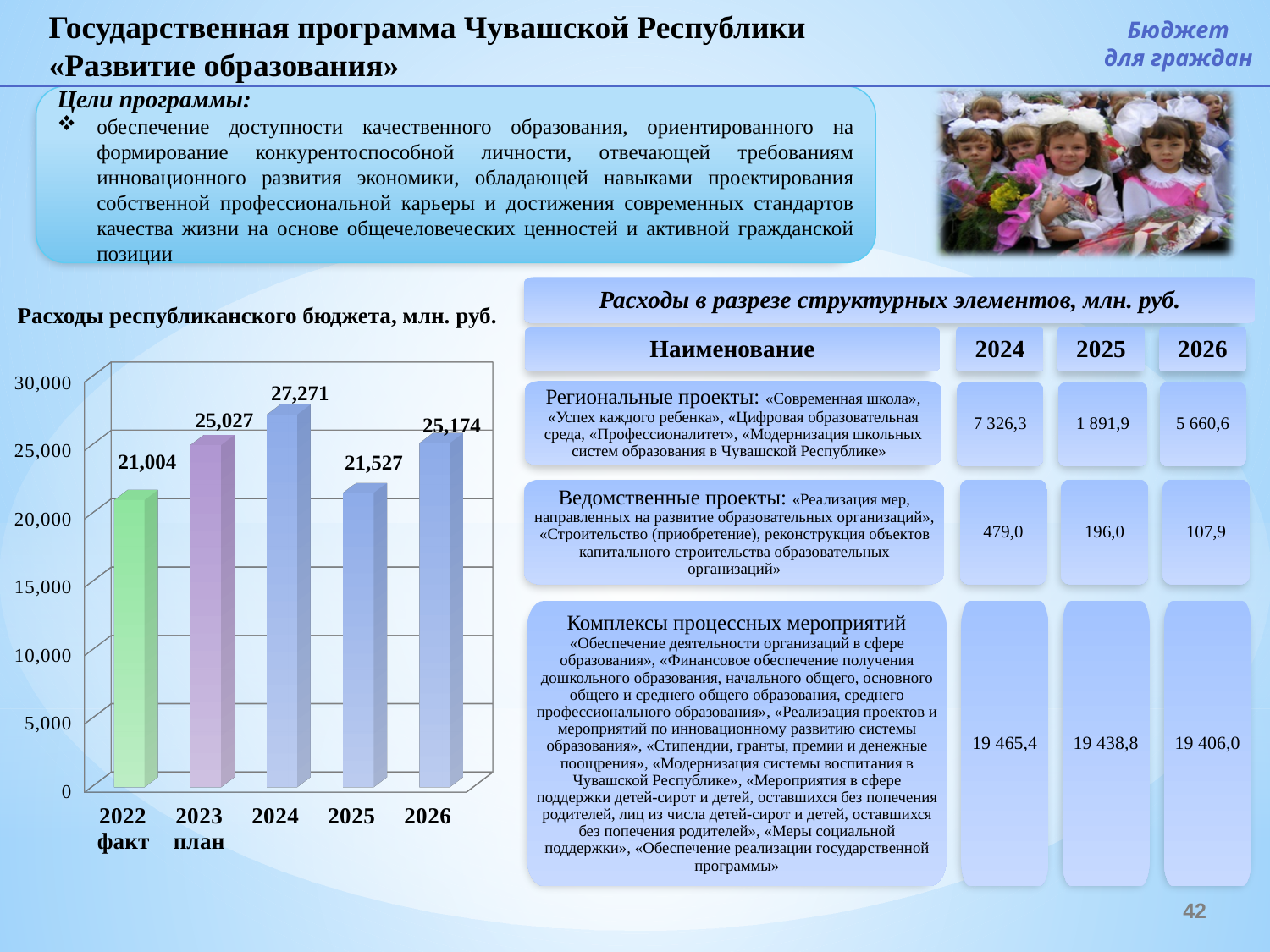
What is the value for 2026 in the chart? 25,174 Which is larger, the value for 2023 план or the value for 2025? 2023 план Which year has the lowest value in the chart? 2022 факт What is the difference between the values for 2024 and 2025? 5,744 What is the difference between the values for 2023 план and 2022 факт? 4,023 Is the value for 2025 greater or less than 25,000? less What is the value for 2024 in the chart 'Расходы республиканского бюджета, млн. руб.'? 27,271 What is the title of the chart on the slide? Расходы республиканского бюджета, млн. руб. How many years are shown in the chart? 5 Which year has the highest value in the chart? 2024 What is the value for 2022 факт in the chart? 21,004 What kind of chart is shown on the slide? bar chart